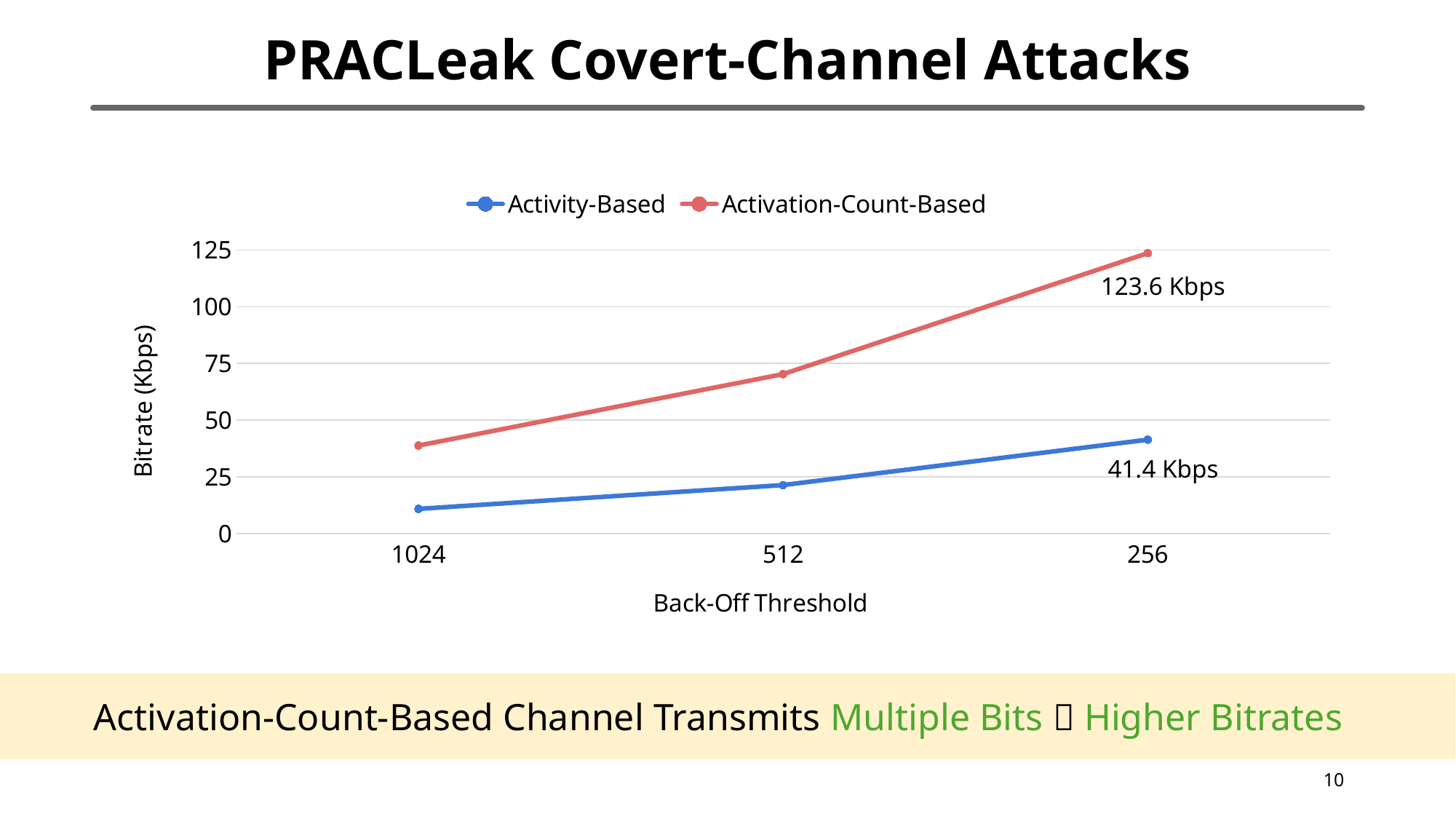
Is the Activity-Based bitrate at a back-off threshold of 1024 greater or less than 25? less How many back-off threshold values are plotted on the x axis? 3 Is the Activation-Count-Based bitrate at a back-off threshold of 1024 greater or less than 50? less What is the bitrate for the Activity-Based series at a back-off threshold of 256? 41.4 Kbps Does the Activation-Count-Based bitrate rise or fall as the back-off threshold goes from 1024 to 256 along the x axis? rise What is the difference between the Activation-Count-Based and Activity-Based bitrates at a back-off threshold of 256? 82.2 Kbps Which series has the higher bitrate at a back-off threshold of 512? Activation-Count-Based At which back-off threshold is the Activity-Based bitrate lowest? 1024 At which back-off threshold does the Activation-Count-Based series reach its highest bitrate? 256 What kind of chart is shown on the slide? line chart What is the bitrate for the Activation-Count-Based series at a back-off threshold of 256? 123.6 Kbps How many series does the legend list? 2